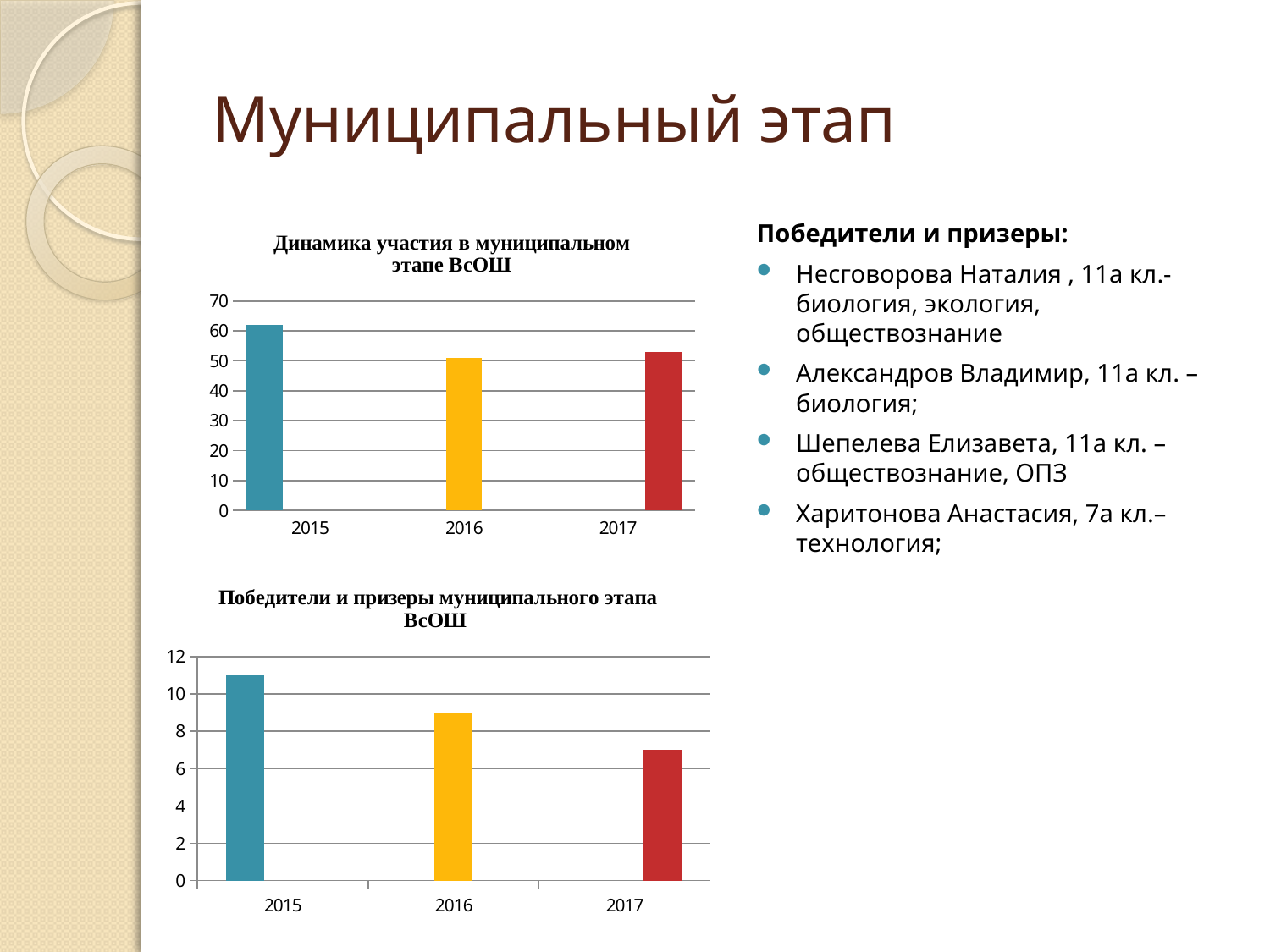
On the chart titled "Победители и призеры муниципального этапа ВсОШ", is the value for 2015 greater or less than 10? greater On the chart titled "Динамика участия в муниципальном этапе ВсОШ", which year has the highest value? 2015 On the chart titled "Победители и призеры муниципального этапа ВсОШ", which year has the highest value? 2015 On the chart titled "Победители и призеры муниципального этапа ВсОШ", which year has the lowest value? 2017 On the chart titled "Победители и призеры муниципального этапа ВсОШ", do the values rise or fall from 2015 to 2017? fall On the chart titled "Динамика участия в муниципальном этапе ВсОШ", is the value for 2015 greater or less than 50? greater On the chart titled "Динамика участия в муниципальном этапе ВсОШ", which is larger, the value for 2015 or the value for 2017? 2015 On the chart titled "Победители и призеры муниципального этапа ВсОШ", is the value for 2017 greater or less than 8? less On the chart titled "Динамика участия в муниципальном этапе ВсОШ", how many years are shown on the x axis? 3 What is the title of the bottom chart on the slide? Победители и призеры муниципального этапа ВсОШ What kind of chart is the top chart, "Динамика участия в муниципальном этапе ВсОШ"? bar chart